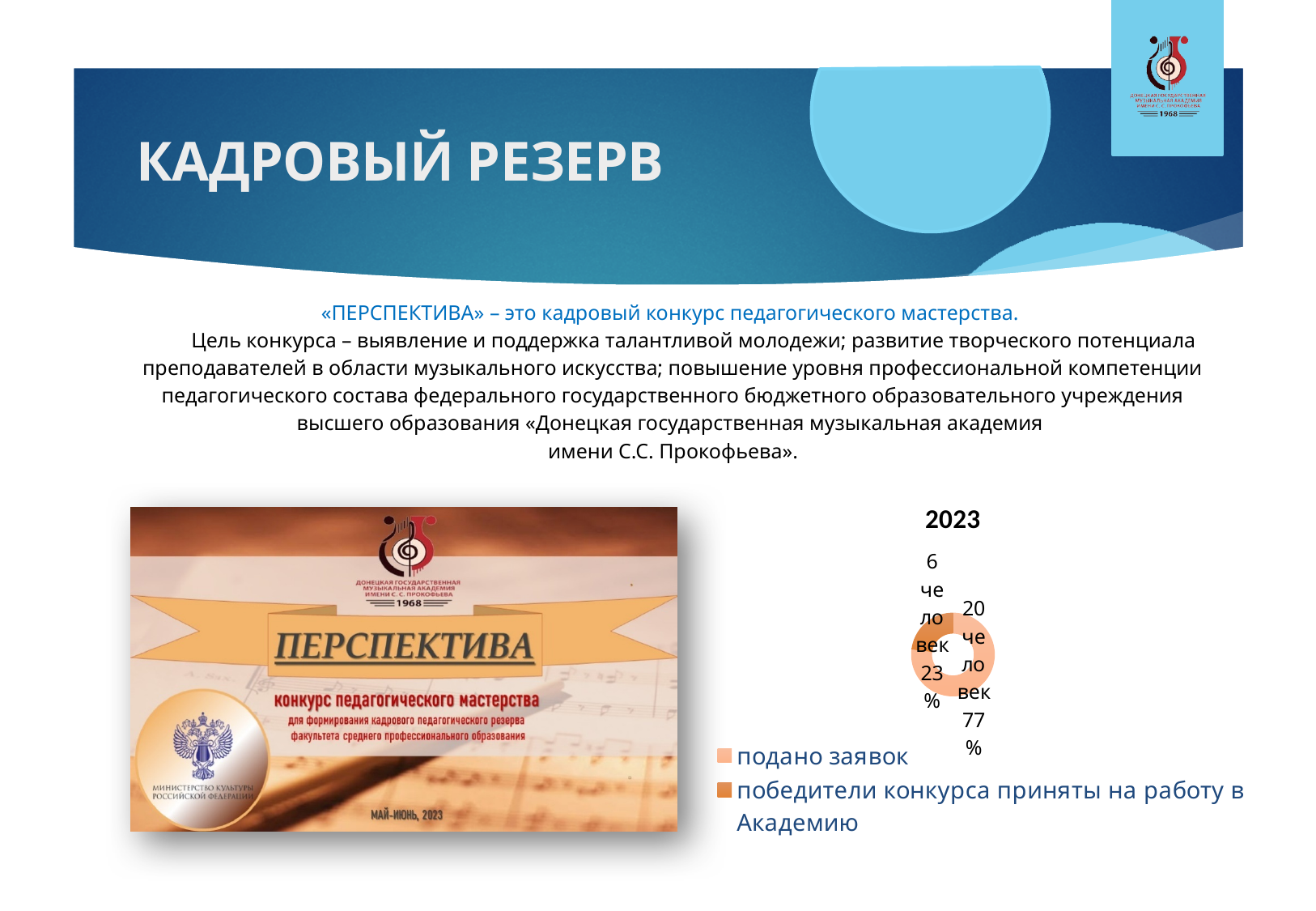
How many entries does the chart legend list? 2 How many people are shown for «победители конкурса приняты на работу в Академию»? 6 человек Which is larger: «подано заявок» or «победители конкурса приняты на работу в Академию»? подано заявок Which slice of the chart is the largest? подано заявок How many slices does the chart have? 2 What is the title of the chart on the slide? 2023 Which slice of the chart is the smallest? победители конкурса приняты на работу в Академию How many people are shown for «подано заявок»? 20 человек What share of the chart does «подано заявок» take? 77% What kind of chart is shown on the slide? doughnut (pie) chart What share of the chart does «победители конкурса приняты на работу в Академию» take? 23% What is the difference in people between «подано заявок» and «победители конкурса приняты на работу в Академию»? 14 человек